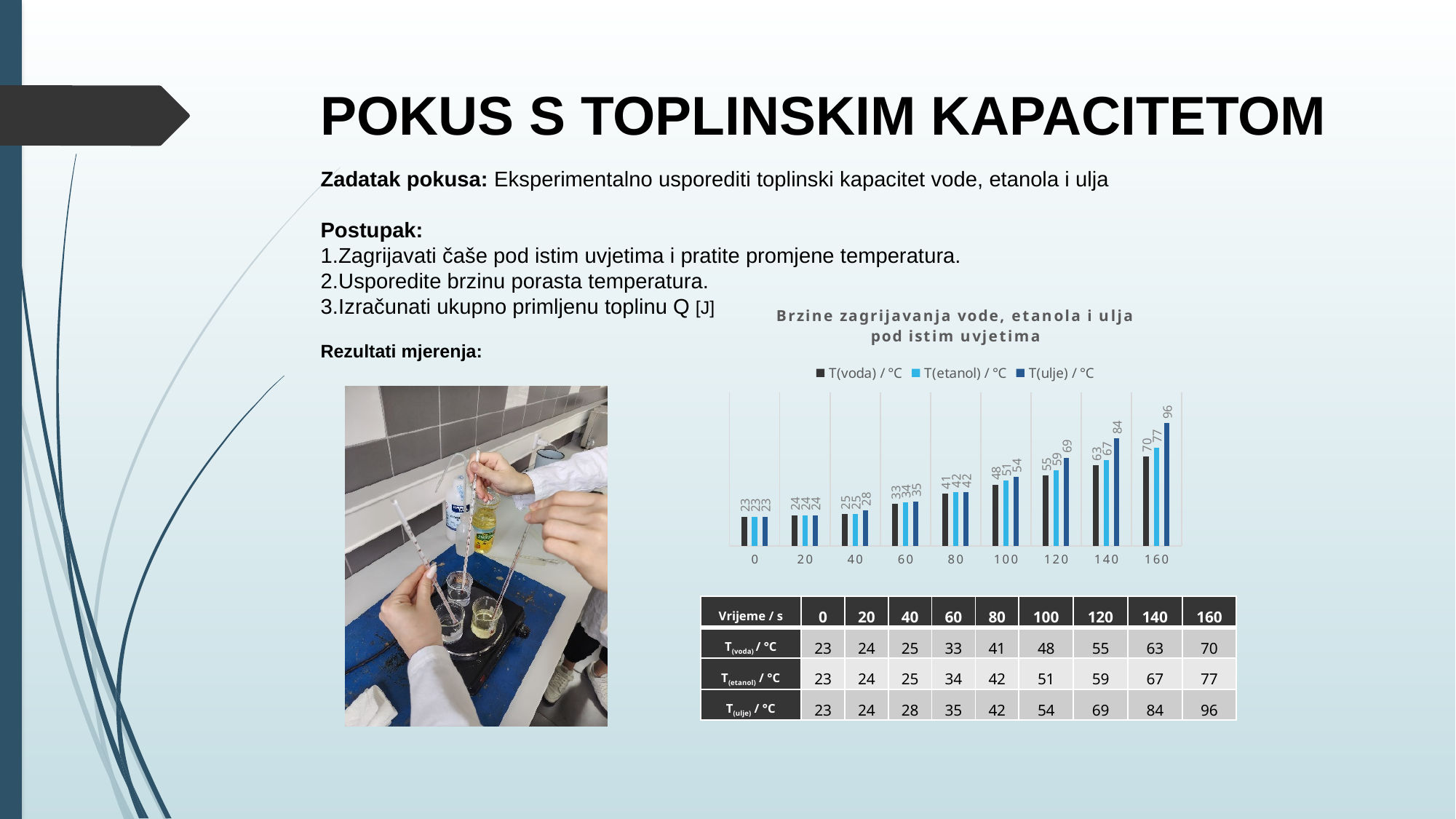
What is the value of T(etanol) / °C at 120 s? 59 What is the value of T(ulje) / °C at 160 s? 96 At 140 s, which is larger: T(etanol) / °C or T(ulje) / °C? T(ulje) / °C Do the T(ulje) / °C values rise or fall as time increases along the x axis? rise What kind of chart is shown? bar chart What is the difference between T(ulje) / °C and T(voda) / °C at 160 s? 26 At which time is T(voda) / °C lowest? 0 What is the title of the chart? Brzine zagrijavanja vode, etanola i ulja pod istim uvjetima How many time points are shown on the x axis? 9 How many series does the legend list? 3 At which time is T(ulje) / °C highest? 160 What is the value of T(voda) / °C at 100 s? 48